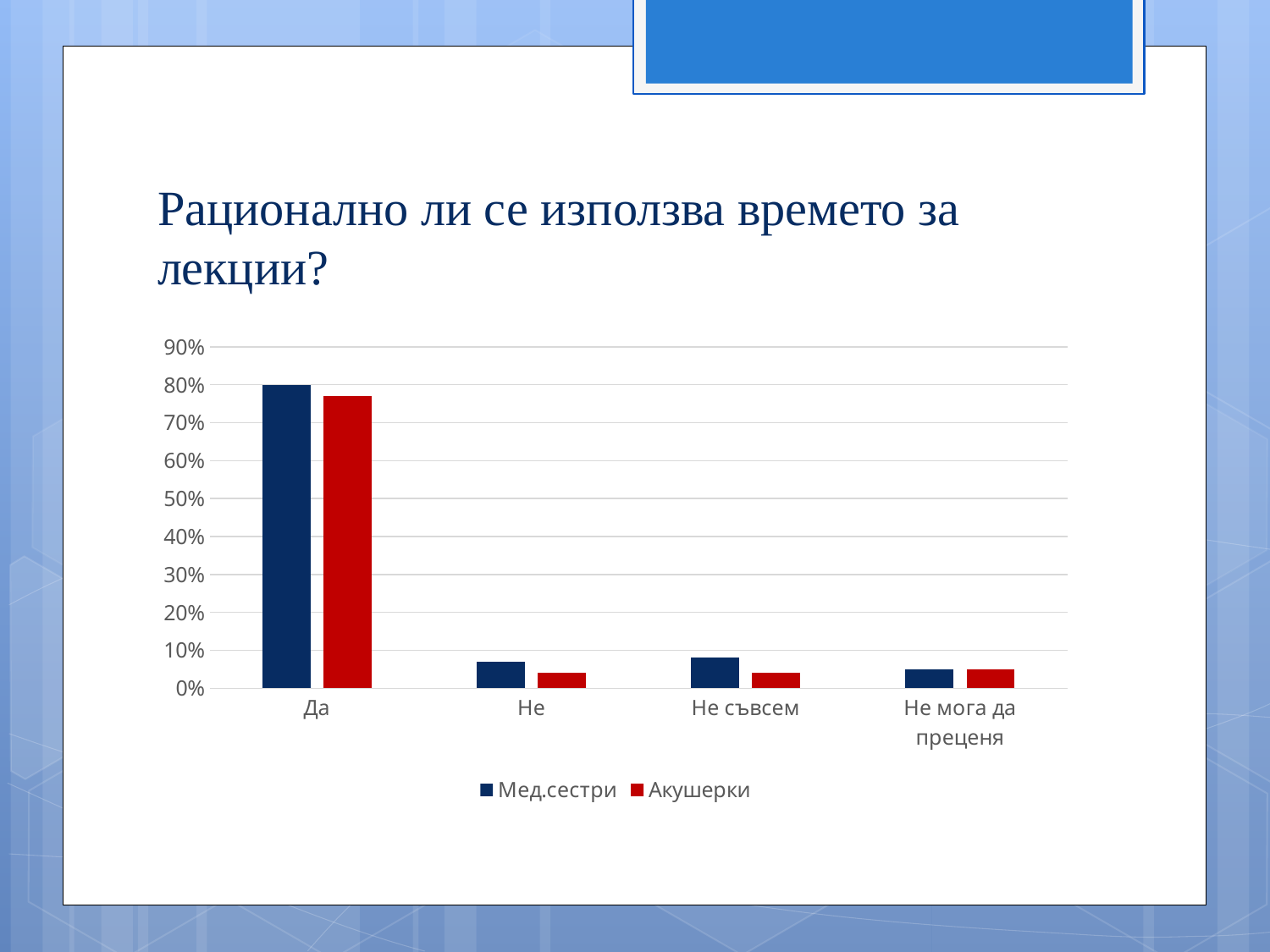
Which category has the highest value for Мед.сестри? Да What is the value for Мед.сестри in the category Да? 80% Is the value for Мед.сестри in the category Не съвсем greater or less than 10%? less Is the value for Акушерки in the category Да greater or less than 70%? greater What kind of chart is shown on the slide? bar chart Is the value for Акушерки in the category Да greater or less than 80%? less How many series does the legend list? 2 How many answer categories are shown on the x axis? 4 In the category Да, which series has the larger value, Мед.сестри or Акушерки? Мед.сестри Which category has the highest value for Акушерки? Да In the category Не, which series has the larger value, Мед.сестри or Акушерки? Мед.сестри Which colour represents the Акушерки series? red